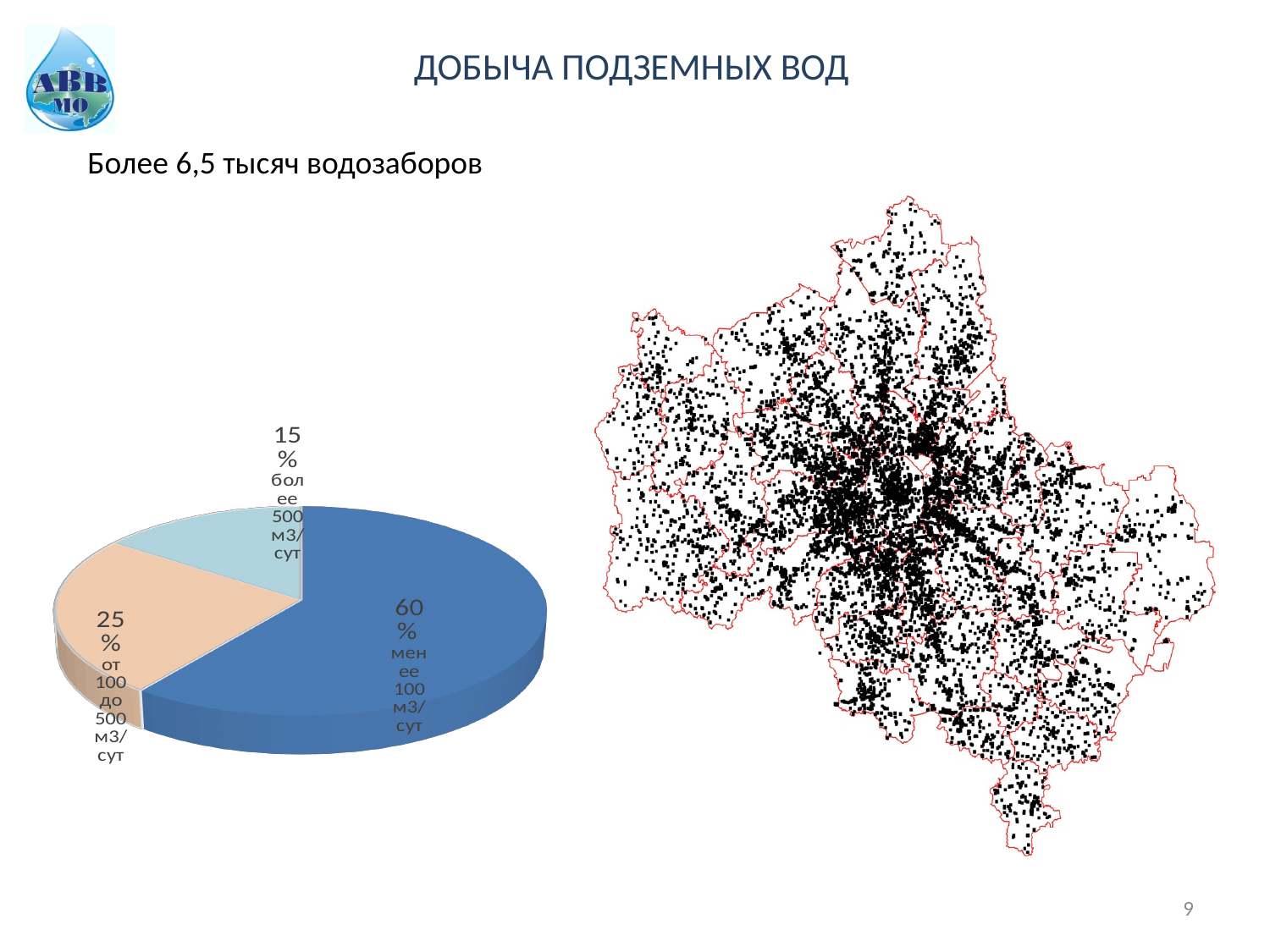
How many slices does the pie chart have? 3 In the pie chart, what is the difference in percentage points between the "от 100 до 500 м3/сут" slice and the "более 500 м3/сут" slice? 10 In the pie chart, which slice is larger: "от 100 до 500 м3/сут" or "более 500 м3/сут"? от 100 до 500 м3/сут What kind of chart is shown on the left of the slide? Pie chart What share of the pie chart is labelled "более 500 м3/сут"? 15% Which category has the largest slice in the pie chart? менее 100 м3/сут What colour is the largest slice of the pie chart? Blue What is the title of the slide containing the pie chart? ДОБЫЧА ПОДЗЕМНЫХ ВОД In the pie chart, what is the difference in percentage points between the "менее 100 м3/сут" slice and the "от 100 до 500 м3/сут" slice? 35 What share of the pie chart is labelled "менее 100 м3/сут"? 60% Which category has the smallest slice in the pie chart? более 500 м3/сут What share of the pie chart is labelled "от 100 до 500 м3/сут"? 25%